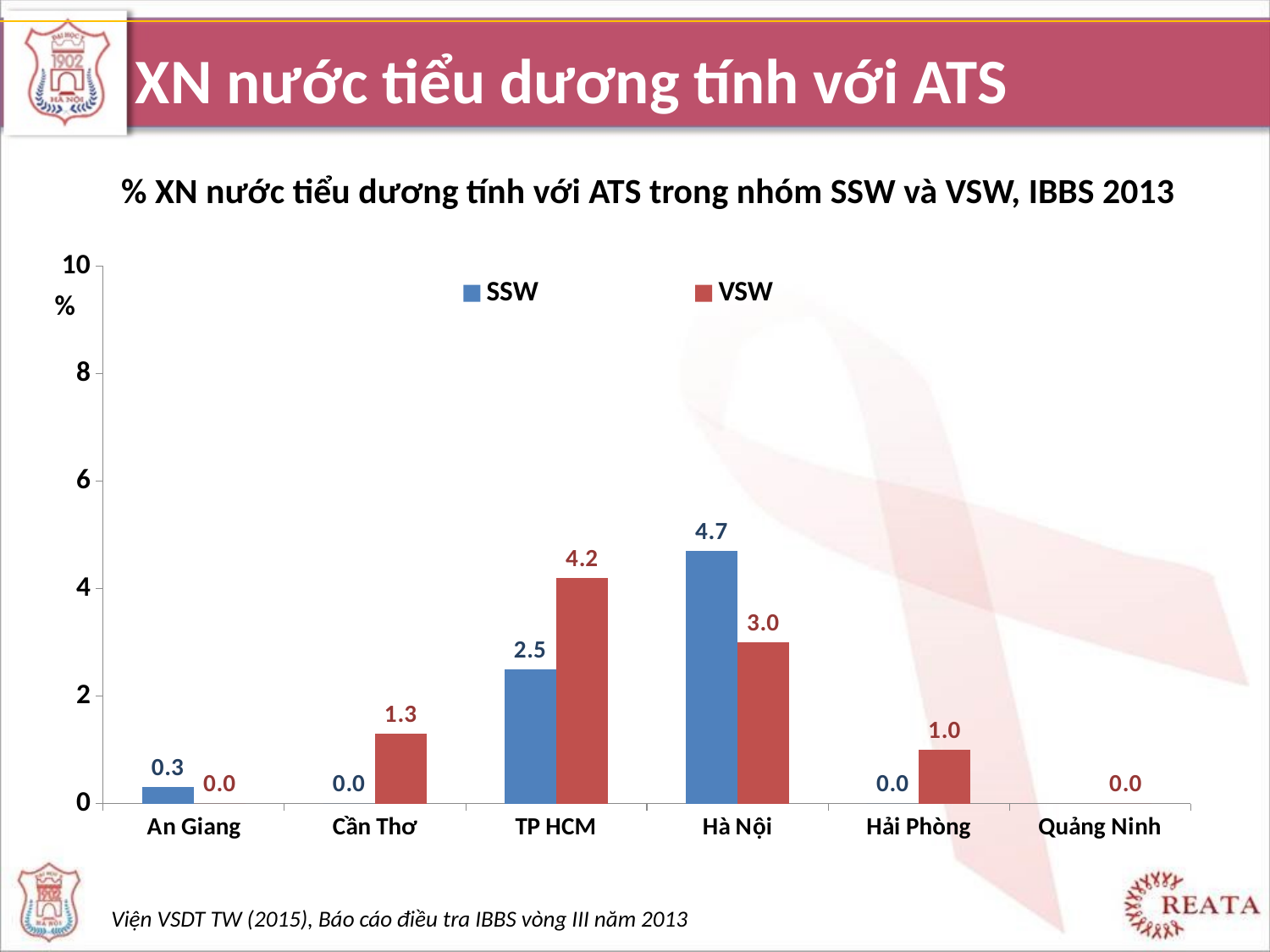
What is the VSW value for Cần Thơ? 1.3 What is the SSW value for Hà Nội? 4.7 What is the difference between the SSW and VSW values for Hà Nội? 1.7 How many provinces are shown on the x axis? 6 How many series does the legend list? 2 What type of chart is shown on the slide? Bar chart What is the difference between the VSW and SSW values for TP HCM? 1.7 Which province has the highest VSW value? TP HCM For Hải Phòng, which is larger, the SSW value or the VSW value? VSW What is the VSW value for TP HCM? 4.2 What is the SSW value for An Giang? 0.3 Which province has the highest SSW value? Hà Nội